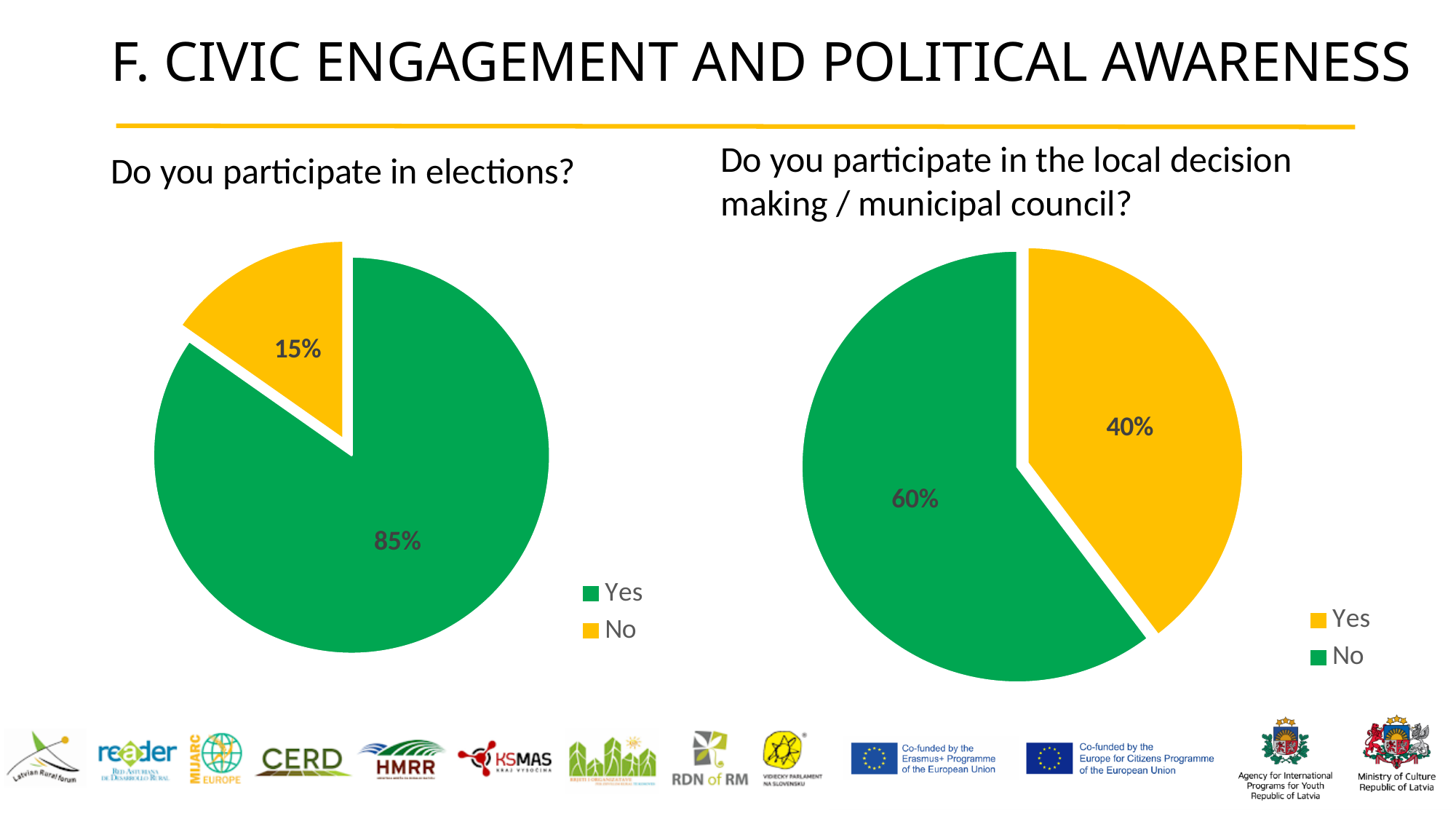
How many slices does the 'Do you participate in the local decision making / municipal council?' pie chart have? 2 In the 'Do you participate in the local decision making / municipal council?' chart, what is the difference in percentage points between the No and Yes slices? 20 In the 'Do you participate in elections?' chart, what share of respondents answered No? 15% What type of chart is used on the left of the slide for 'Do you participate in elections?'? Pie chart In the 'Do you participate in the local decision making / municipal council?' chart, what colour is the Yes slice? Yellow Which is larger: the Yes share in the elections chart or the Yes share in the local decision making chart? The Yes share in the elections chart In the 'Do you participate in elections?' chart, what is the difference in percentage points between the Yes and No slices? 70 In the 'Do you participate in the local decision making / municipal council?' chart, what share of respondents answered Yes? 40% In the 'Do you participate in elections?' chart, which answer has the largest slice? Yes In the 'Do you participate in the local decision making / municipal council?' chart, what share of respondents answered No? 60% In the 'Do you participate in elections?' chart, what share of respondents answered Yes? 85% In the 'Do you participate in the local decision making / municipal council?' chart, which answer has the smallest slice? Yes